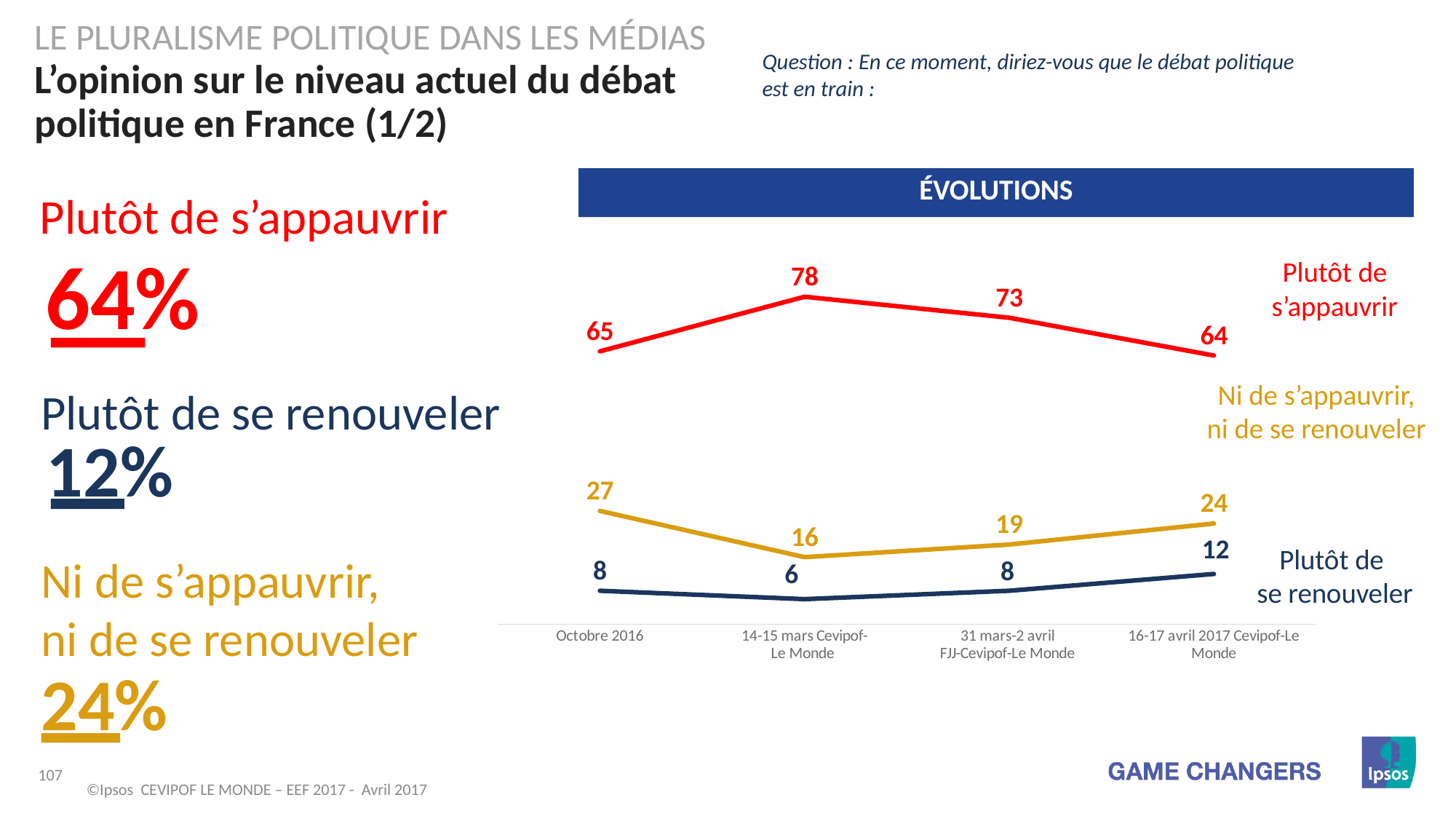
At which survey date is "Plutôt de se renouveler" at its lowest? 14-15 mars Cevipof-Le Monde What is the value for "Plutôt de se renouveler" at 16-17 avril 2017 Cevipof-Le Monde? 12 What colour is the line for "Plutôt de s'appauvrir"? Red How many series are plotted in the chart? 3 Does the "Ni de s'appauvrir, ni de se renouveler" series rise or fall between 14-15 mars and 16-17 avril 2017? Rise Which is larger at 31 mars-2 avril: "Ni de s'appauvrir, ni de se renouveler" or "Plutôt de se renouveler"? Ni de s'appauvrir, ni de se renouveler What is the value for "Plutôt de s'appauvrir" at 14-15 mars Cevipof-Le Monde? 78 What kind of chart is shown under the "ÉVOLUTIONS" heading? Line chart What is the difference between the "Plutôt de s'appauvrir" values at 14-15 mars and 16-17 avril 2017? 14 At which survey date does "Plutôt de s'appauvrir" reach its highest value? 14-15 mars Cevipof-Le Monde How many survey dates are plotted on the x axis? 4 What is the value for "Ni de s'appauvrir, ni de se renouveler" in Octobre 2016? 27